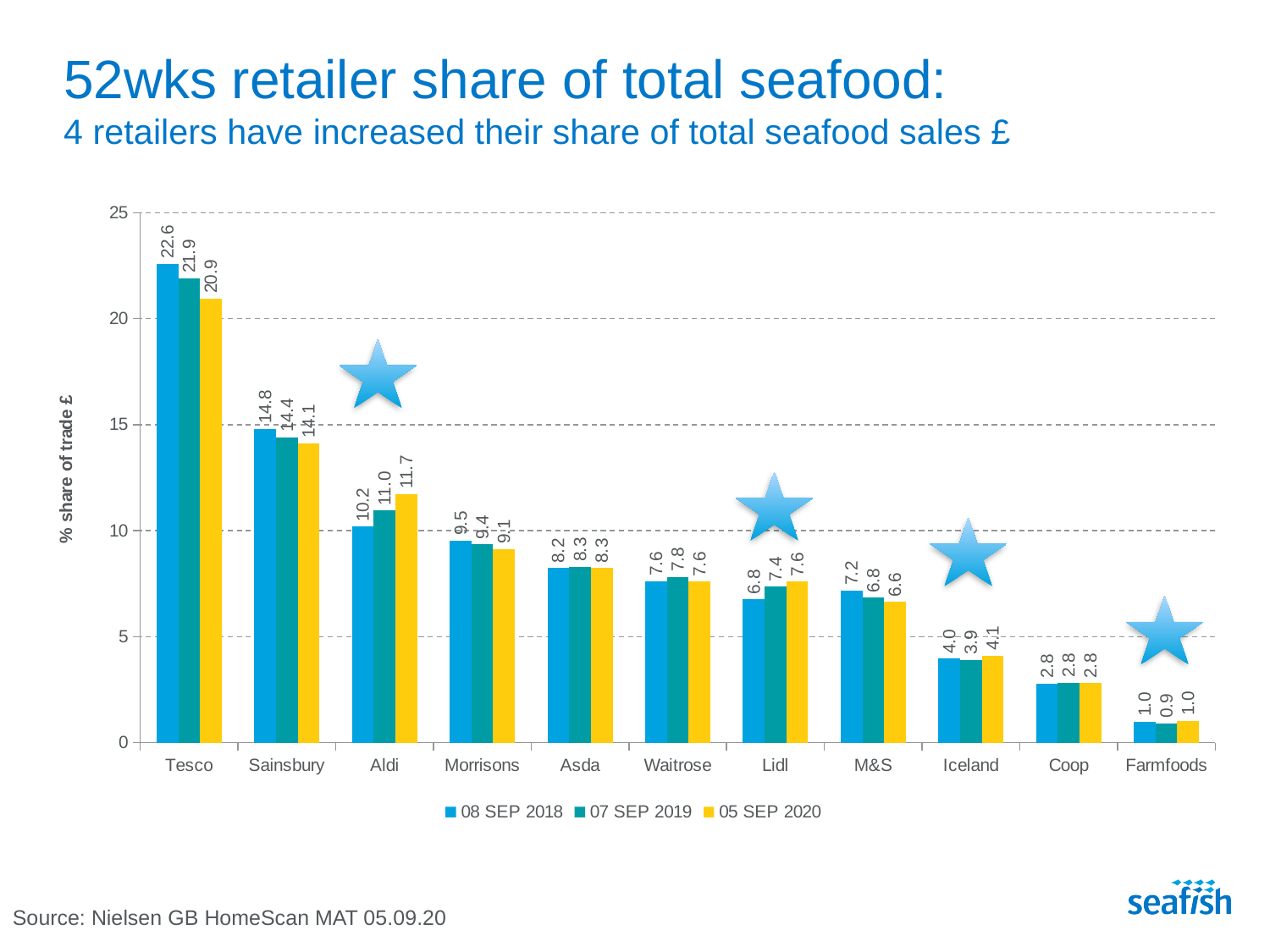
What kind of chart is shown on the slide? bar chart How many series does the legend list? 3 Is the value for Morrisons in the 05 SEP 2020 series greater or less than 10? less What is the label of the y axis? % share of trade £ What is the difference between Tesco's 08 SEP 2018 value and its 05 SEP 2020 value? 1.7 Which is larger for Sainsbury: the 08 SEP 2018 value or the 05 SEP 2020 value? 08 SEP 2018 Which retailer has the lowest share in the 08 SEP 2018 series? Farmfoods Which retailer has the highest share in the 05 SEP 2020 series? Tesco How many retailers are shown on the x axis? 11 What is the value for Tesco in the 05 SEP 2020 series? 20.9 What is the value for Lidl in the 07 SEP 2019 series? 7.4 What is the value for Aldi in the 08 SEP 2018 series? 10.2